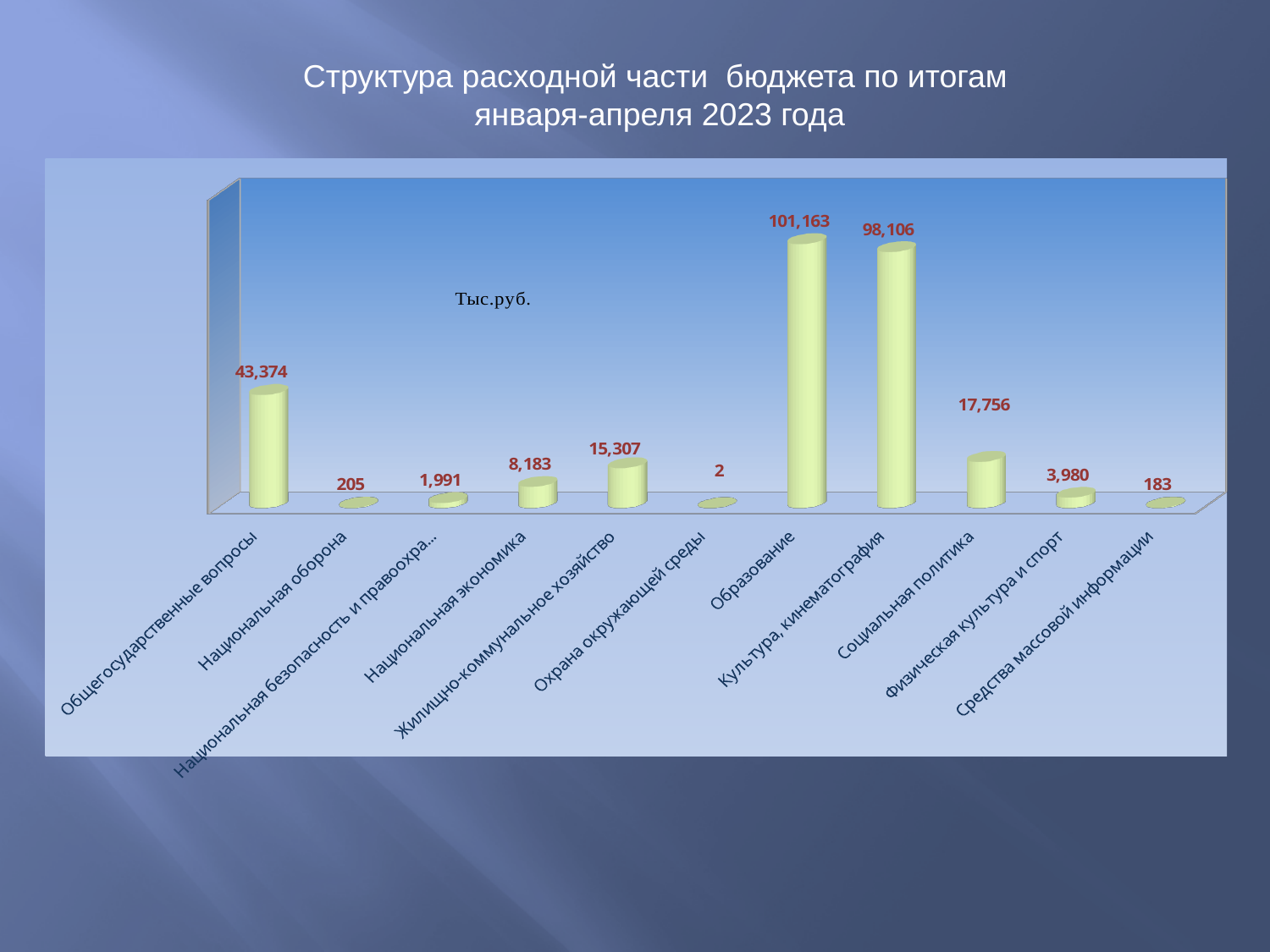
What is the value for Социальная политика? 17,756 Which category has the lowest value? Охрана окружающей среды What is the value for Физическая культура и спорт? 3,980 What is the difference between the values for Общегосударственные вопросы and Социальная политика? 25,618 Which category has the highest value? Образование How many categories are shown on the chart? 11 What is the value for Общегосударственные вопросы? 43,374 What kind of chart is shown on the slide? Bar chart What is the value for Образование? 101,163 Which is larger, the value for Жилищно-коммунальное хозяйство or the value for Национальная экономика? Жилищно-коммунальное хозяйство What is the difference between the values for Образование and Культура, кинематография? 3,057 What unit is indicated on the chart? Тыс.руб.